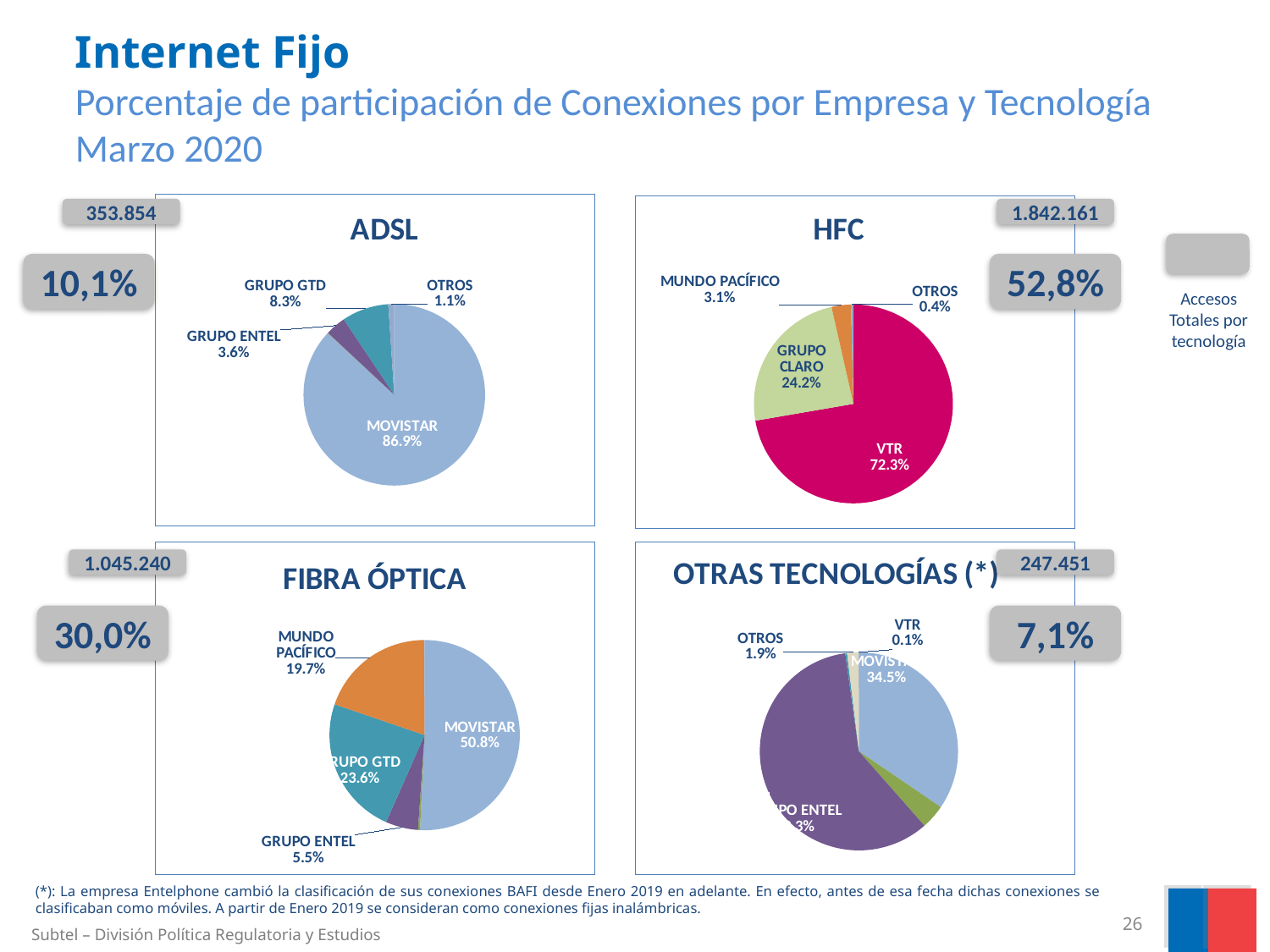
In the ADSL chart, what share does MOVISTAR hold? 86.9% In the FIBRA ÓPTICA chart, what share does MUNDO PACÍFICO hold? 19.7% In the HFC chart, which company has the largest share? VTR In the FIBRA ÓPTICA chart, what is the difference between the shares of MOVISTAR and GRUPO ENTEL? 45.3% In the OTRAS TECNOLOGÍAS (*) chart, what share does MOVISTAR hold? 34.5% In the ADSL chart, what share does GRUPO GTD hold? 8.3% In the HFC chart, what is the difference between the shares of VTR and GRUPO CLARO? 48.1% In the FIBRA ÓPTICA chart, which is larger, the share of GRUPO GTD or the share of MUNDO PACÍFICO? GRUPO GTD What kind of chart is used for the ADSL data? Pie chart How many charts are shown on the slide? 4 In the HFC chart, which company has the smallest share? OTROS In the HFC chart, what share does GRUPO CLARO hold? 24.2%